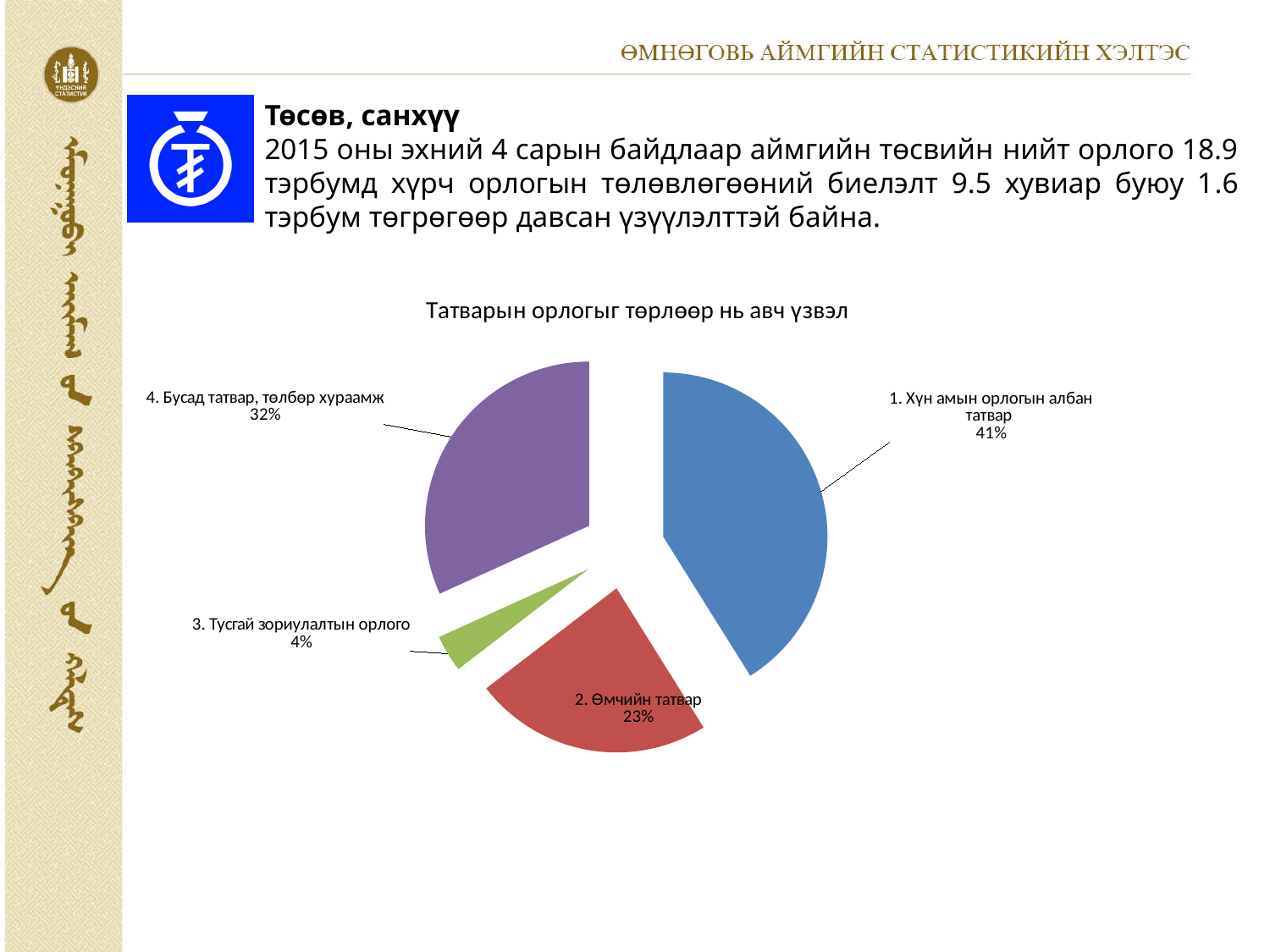
How many slices does the pie chart have? 4 Which category has the largest slice of the pie? 1. Хүн амын орлогын албан татвар What share of the pie does "2. Өмчийн татвар" represent? 23% What colour is the slice for "2. Өмчийн татвар"? Red Which is larger: the share for "2. Өмчийн татвар" or the share for "4. Бусад татвар, төлбөр хураамж"? 4. Бусад татвар, төлбөр хураамж What share of the pie does "1. Хүн амын орлогын албан татвар" represent? 41% What is the difference in percentage points between "1. Хүн амын орлогын албан татвар" and "4. Бусад татвар, төлбөр хураамж"? 9 percentage points What is the title of the chart? Татварын орлогыг төрлөөр нь авч үзвэл What kind of chart is shown on the slide? Pie chart What share of the pie does "4. Бусад татвар, төлбөр хураамж" represent? 32% Which category has the smallest slice of the pie? 3. Тусгай зориулалтын орлого